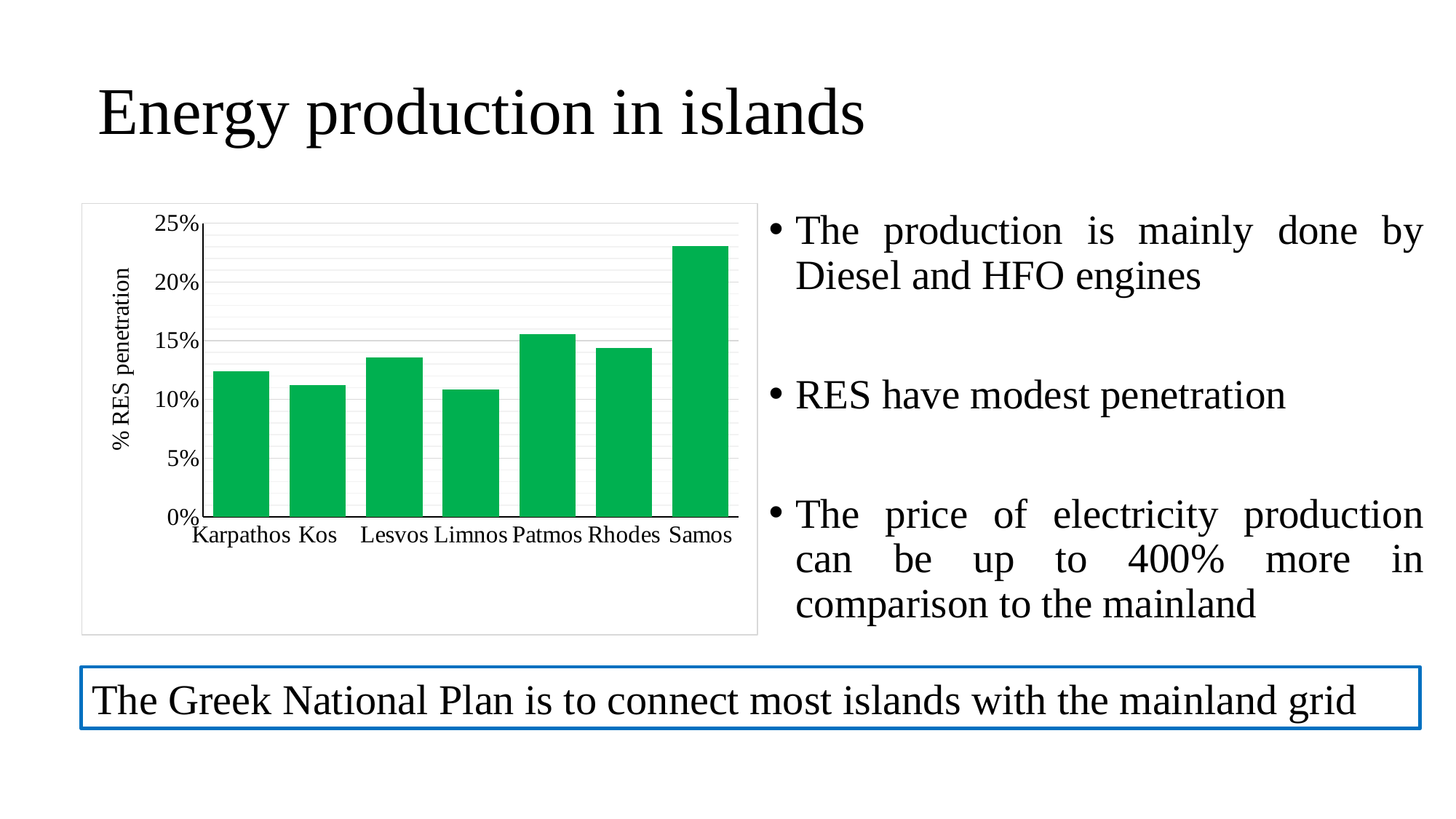
Is the value for Limnos greater or less than 10%? greater Which island has the highest % RES penetration in the chart? Samos What kind of chart is shown on the slide? bar chart How many islands are shown on the x axis of the chart? 7 Is the value for Kos greater or less than 15%? less Is the value for Rhodes greater or less than 10%? greater Which has a higher % RES penetration, Lesvos or Kos? Lesvos What is the label of the vertical axis of the chart? % RES penetration Which has a higher % RES penetration, Samos or Patmos? Samos